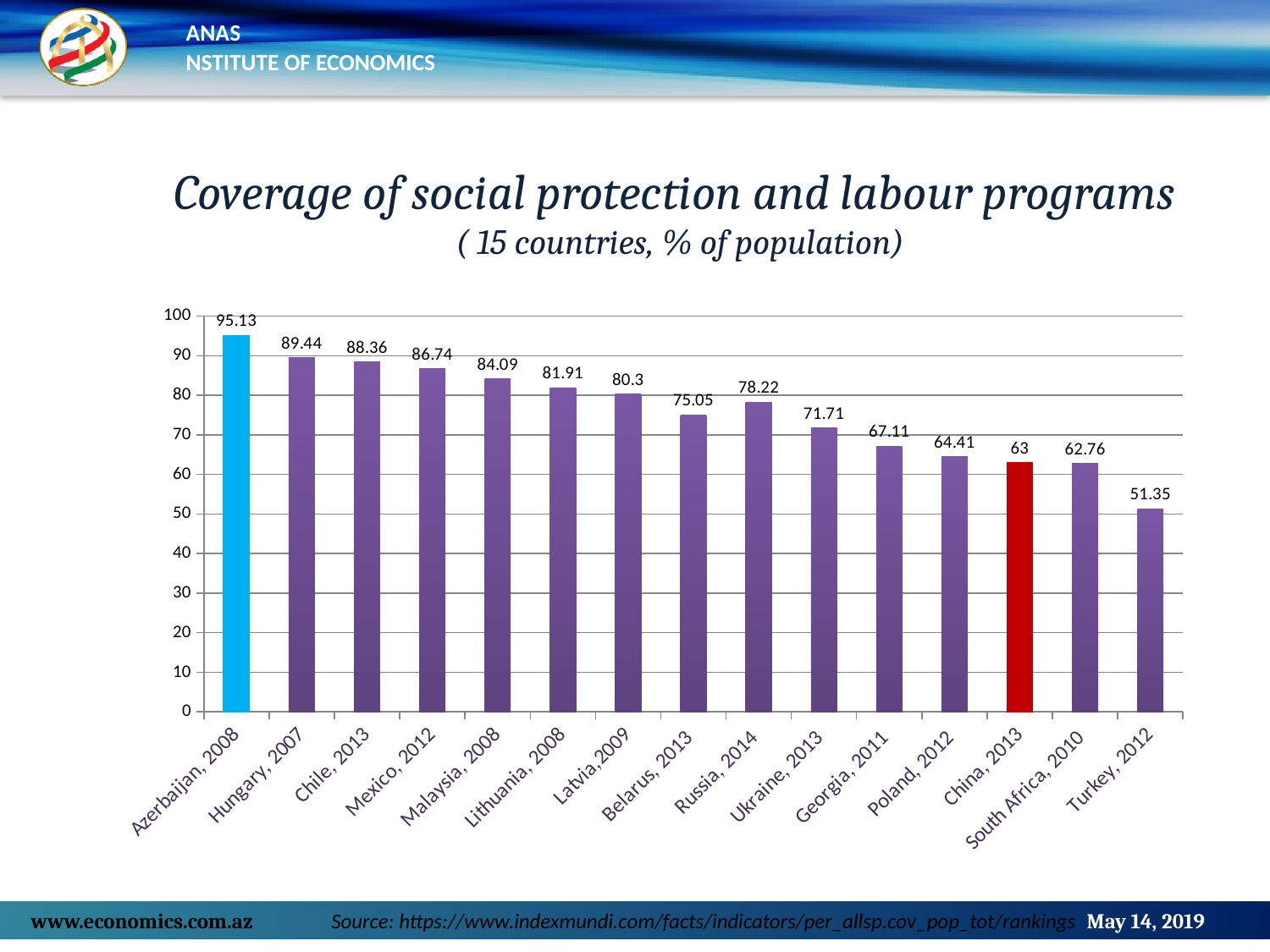
How many countries are shown in the chart? 15 Which country has the highest coverage value? Azerbaijan, 2008 What type of chart is shown on the slide? Bar chart Which country has the lowest coverage value? Turkey, 2012 What is the difference between the values for Russia, 2014 and Belarus, 2013? 3.17 What is the difference between the values for Azerbaijan, 2008 and Turkey, 2012? 43.78 What is the value for Latvia, 2009? 80.3 Which country's bar is coloured red? China, 2013 What is the value for Azerbaijan, 2008? 95.13 What is the value for China, 2013? 63 Which is larger, the value for Russia, 2014 or the value for Belarus, 2013? Russia, 2014 Do the values generally rise or fall from left to right along the x axis? Fall